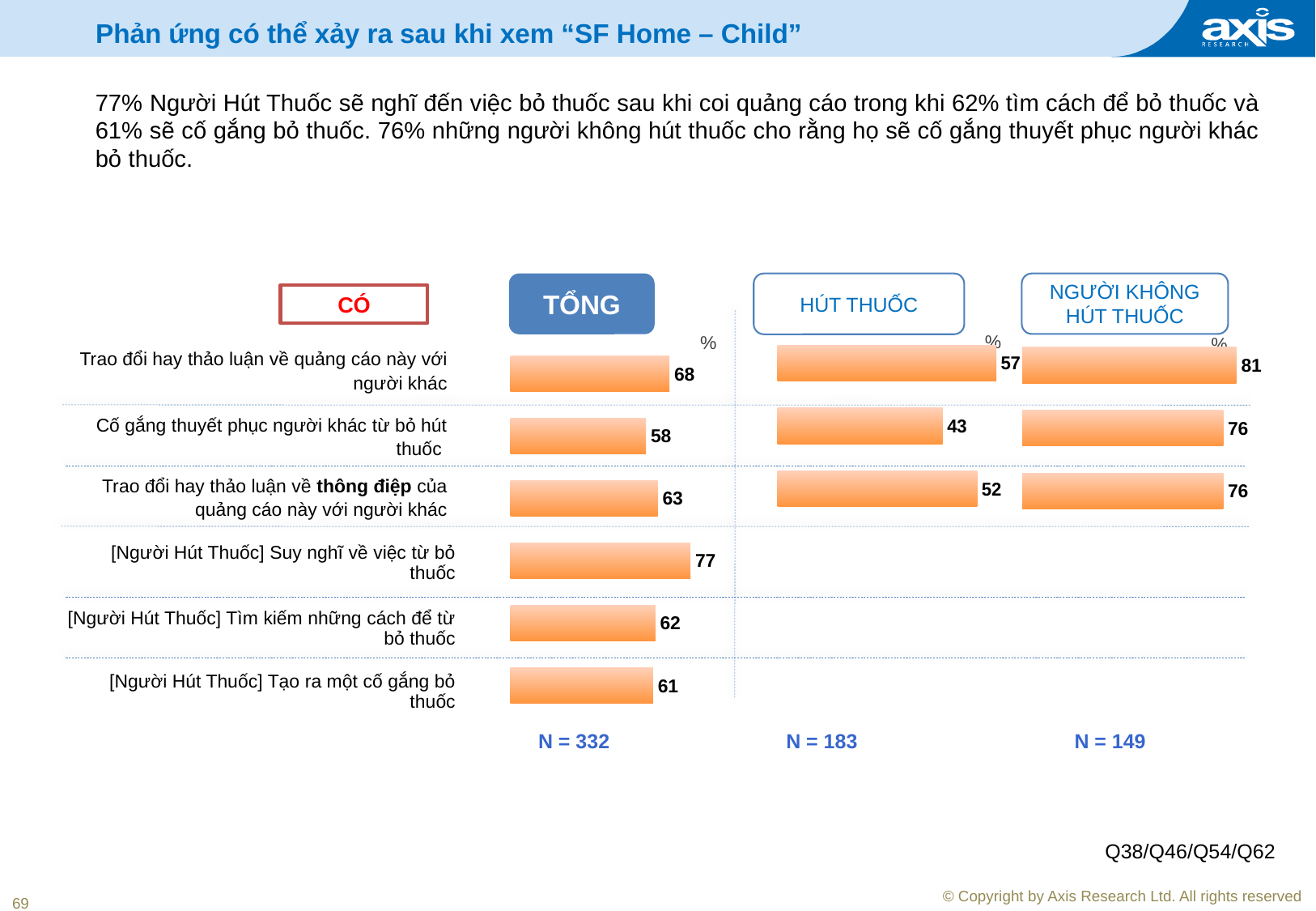
In the TỔNG chart, what is the value for "Trao đổi hay thảo luận về quảng cáo này với người khác"? 68 In the NGƯỜI KHÔNG HÚT THUỐC chart, what is the value for "Trao đổi hay thảo luận về quảng cáo này với người khác"? 81 How many categories have bars in the HÚT THUỐC chart? 3 How many categories are plotted in the TỔNG chart? 6 In the HÚT THUỐC chart, what is the value for "Cố gắng thuyết phục người khác từ bỏ hút thuốc"? 43 In the HÚT THUỐC chart, which category has the lowest value? Cố gắng thuyết phục người khác từ bỏ hút thuốc What kind of chart is used to show the TỔNG values? Bar chart What is the sample size (N) shown under the HÚT THUỐC chart? N = 183 What is the difference between the NGƯỜI KHÔNG HÚT THUỐC and HÚT THUỐC values for "Cố gắng thuyết phục người khác từ bỏ hút thuốc"? 33 In the TỔNG chart, which category has the lowest value? Cố gắng thuyết phục người khác từ bỏ hút thuốc In the TỔNG chart, which category has the highest value? [Người Hút Thuốc] Suy nghĩ về việc từ bỏ thuốc For "Trao đổi hay thảo luận về thông điệp của quảng cáo này với người khác", which group has the larger value: HÚT THUỐC or NGƯỜI KHÔNG HÚT THUỐC? NGƯỜI KHÔNG HÚT THUỐC